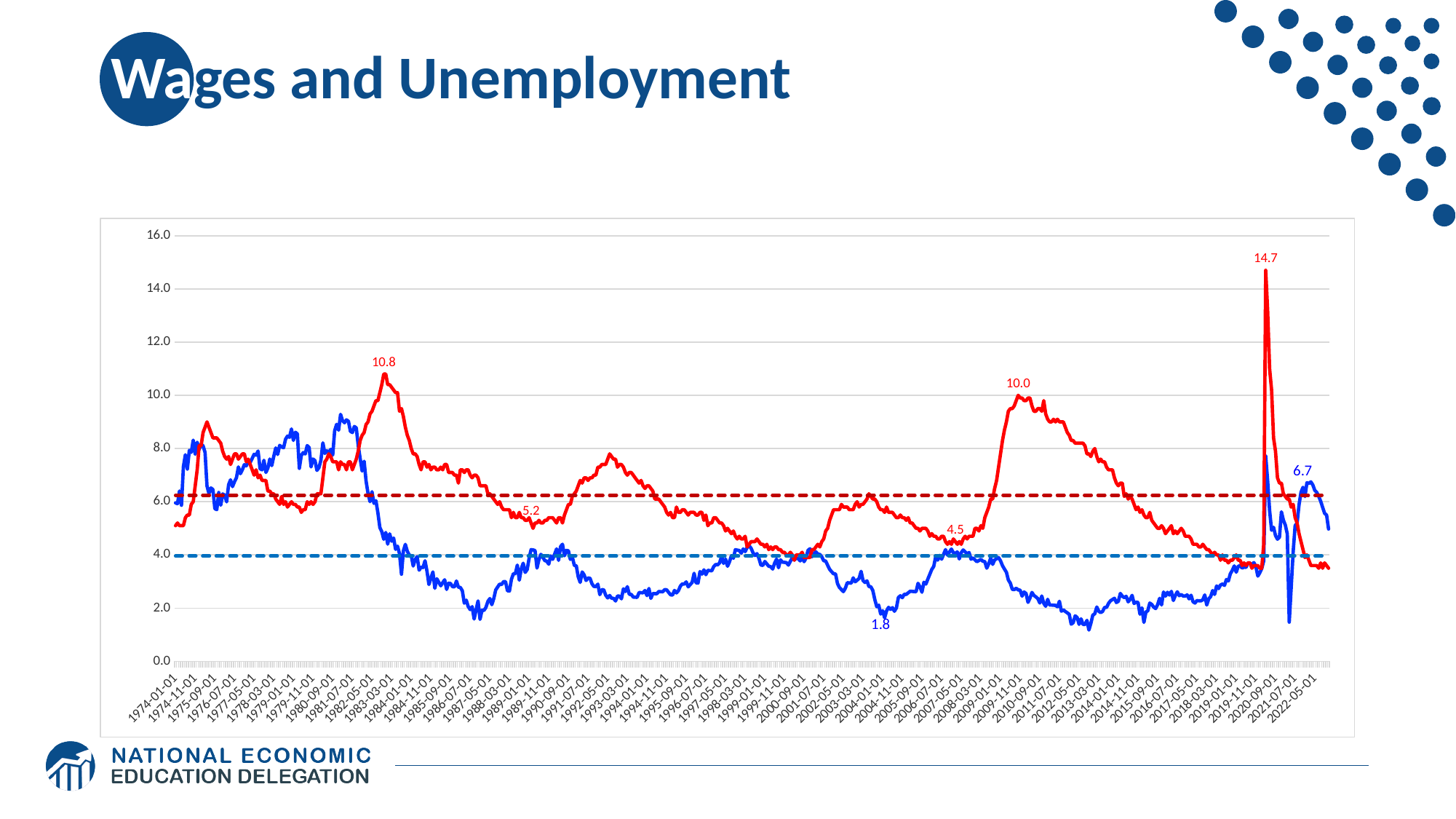
What is the difference between the red line's 10.8 peak and its 10.0 peak? 0.8 Is the red line's peak around 2020 greater or less than 14.0? greater What is the lowest labelled value on the blue line? 1.8 What is the labelled peak value of the blue line near the end of the series? 6.7 How many data labels are printed on the chart? 7 What is the difference between the red line's 14.7 peak and its 10.8 peak? 3.9 Which is larger: the red line's labelled peak of 14.7 or the blue line's labelled peak of 6.7? 14.7 (red line) What is the highest labelled value on the red line? 14.7 What is the labelled peak value of the red line around 1983? 10.8 What kind of chart is shown on the slide? line chart What is the labelled value on the red line around 2007? 4.5 What is the title of the slide containing the chart? Wages and Unemployment